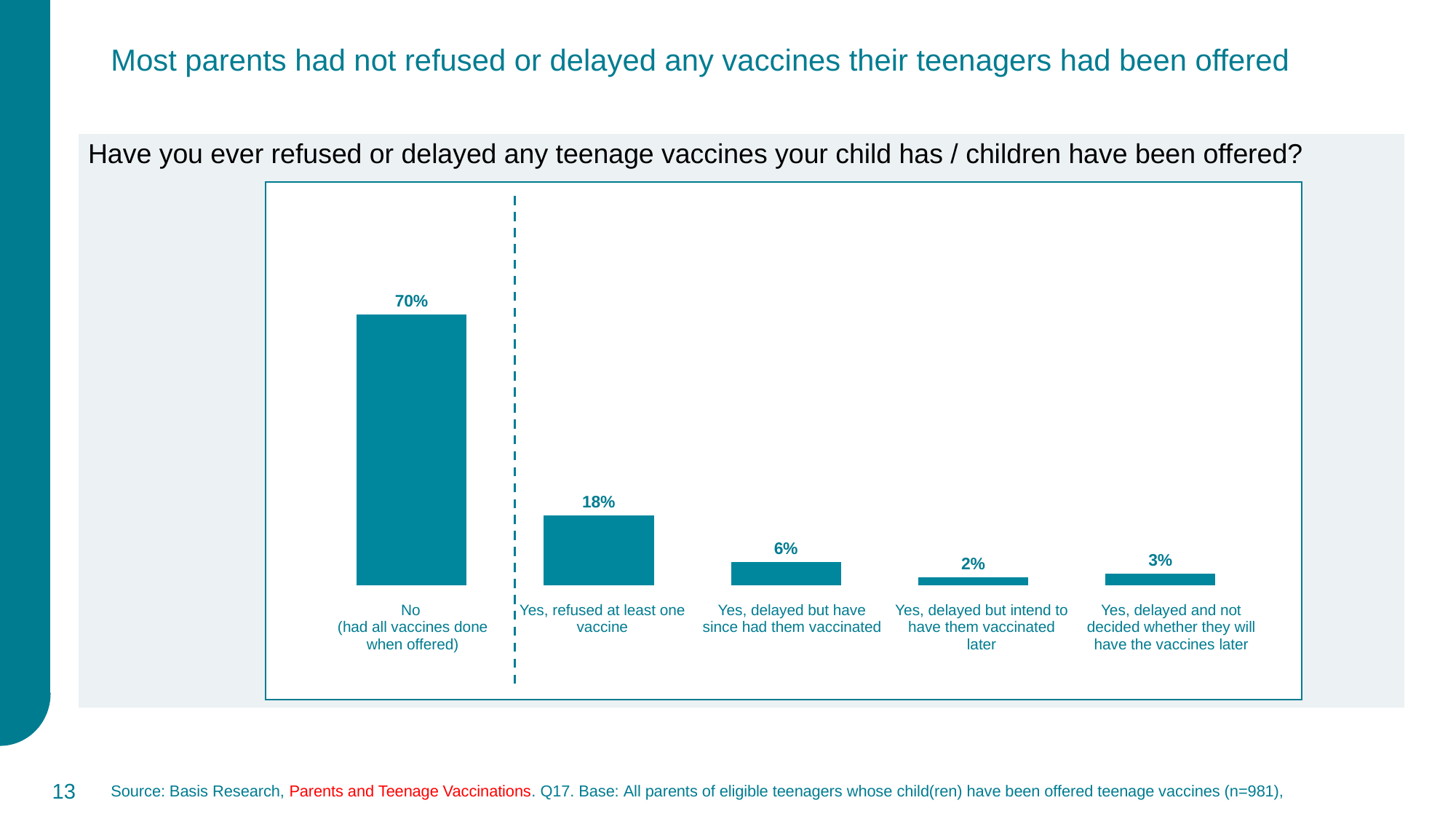
What is the value for "Yes, delayed and not decided whether they will have the vaccines later"? 3% Which response category has the highest value? No (had all vaccines done when offered) What is the difference between the "No" category and "Yes, refused at least one vaccine"? 52 percentage points What percentage of parents answered "No (had all vaccines done when offered)"? 70% What is the value for "Yes, delayed but intend to have them vaccinated later"? 2% Which response category has the lowest value? Yes, delayed but intend to have them vaccinated later What type of chart is shown on the slide? Bar chart What percentage of parents said "Yes, refused at least one vaccine"? 18% Which is larger: "Yes, delayed and not decided whether they will have the vaccines later" or "Yes, delayed but intend to have them vaccinated later"? Yes, delayed and not decided whether they will have the vaccines later How many response categories are shown in the chart? 5 What is the value for "Yes, delayed but have since had them vaccinated"? 6% What question is the chart based on, as shown above the chart? Have you ever refused or delayed any teenage vaccines your child has / children have been offered?